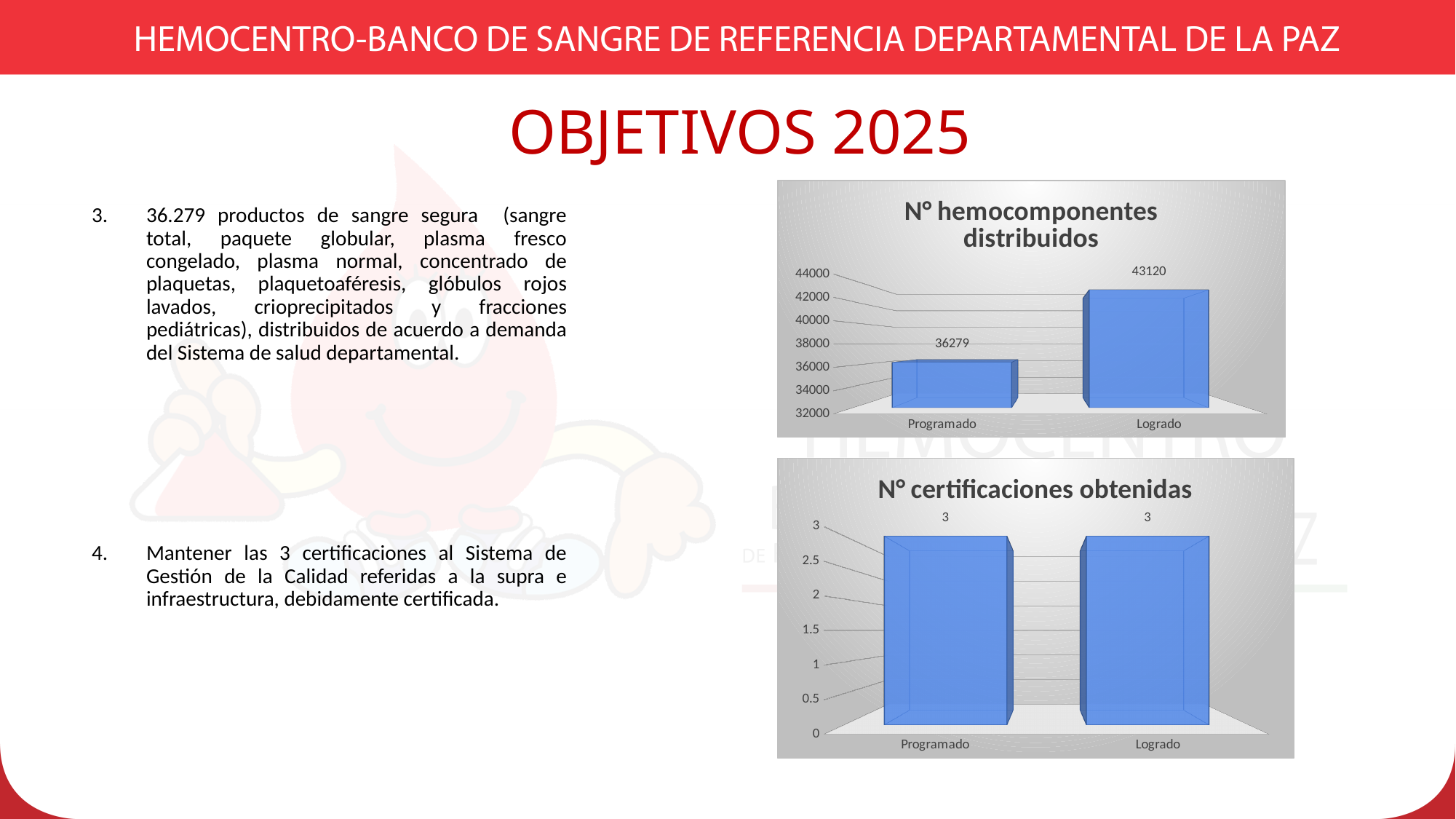
In the 'N° certificaciones obtenidas' chart, what is the value for Logrado? 3 In the 'N° hemocomponentes distribuidos' chart, is the value for Logrado greater or less than 40000? greater In the 'N° hemocomponentes distribuidos' chart, what is the difference between Logrado and Programado? 6841 In the 'N° certificaciones obtenidas' chart, is the value for Logrado greater or less than 2? greater What kind of chart is 'N° hemocomponentes distribuidos'? bar chart How many charts are shown on the slide? 2 In the 'N° hemocomponentes distribuidos' chart, which category has the highest value? Logrado In the 'N° hemocomponentes distribuidos' chart, what is the value for Logrado? 43120 In the 'N° hemocomponentes distribuidos' chart, how many categories are shown? 2 In the 'N° hemocomponentes distribuidos' chart, what is the value for Programado? 36279 In the 'N° certificaciones obtenidas' chart, what is the difference between Programado and Logrado? 0 In the 'N° certificaciones obtenidas' chart, what is the value for Programado? 3